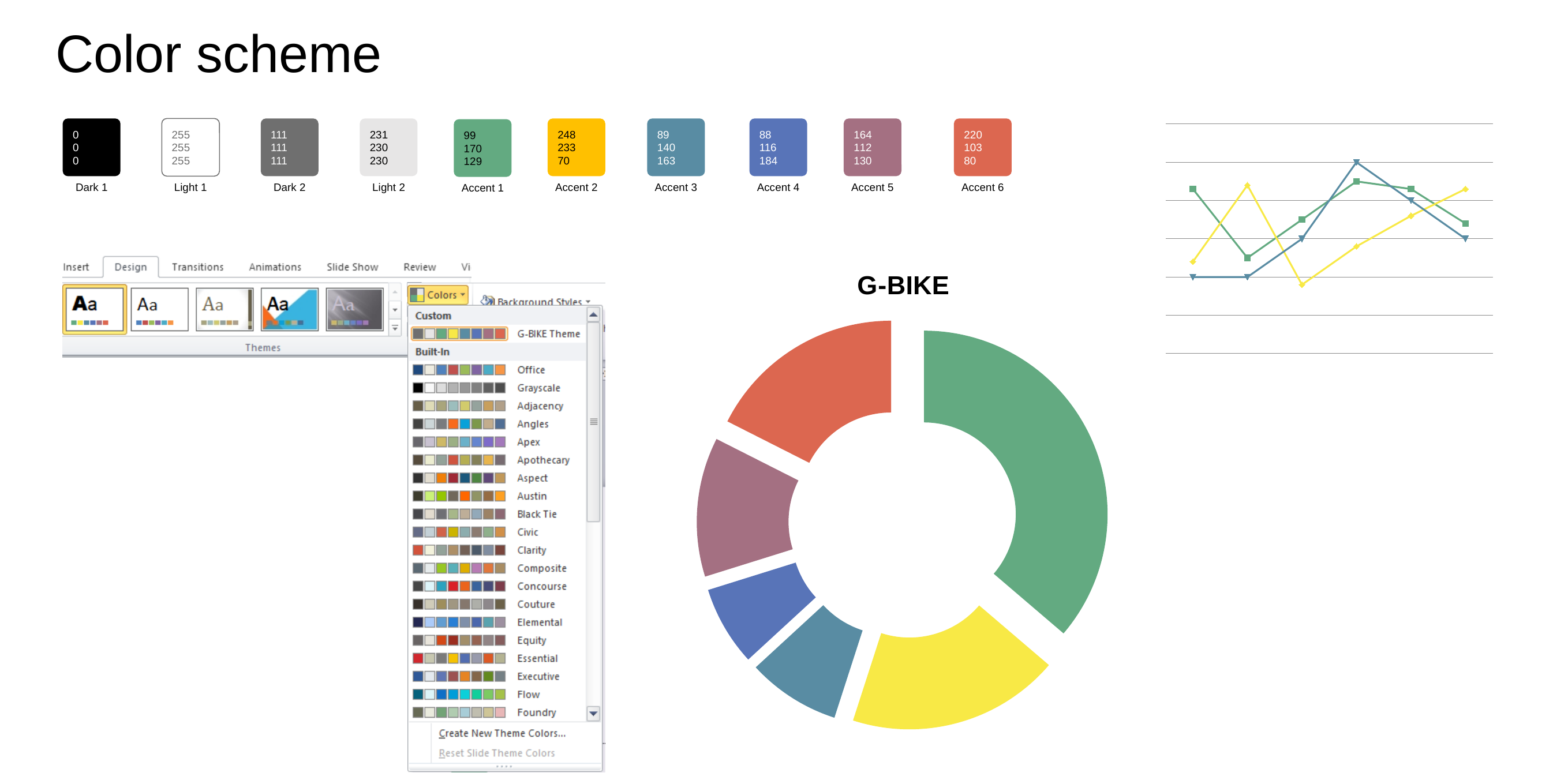
In the top-right line chart, which line has the highest value at the fourth point on the x axis? blue In the G-BIKE doughnut chart, which colour slice is the largest? green What is the title of the doughnut chart in the middle of the slide? G-BIKE What colours are the three lines in the top-right line chart? green, blue and yellow What kind of chart is the G-BIKE chart? doughnut chart In the top-right line chart, which line has the highest value at the first point on the x axis? green What kind of chart is shown at the top right of the slide? line chart How many lines are plotted in the line chart at the top right of the slide? 3 How many slices does the G-BIKE doughnut chart have? 6 In the G-BIKE doughnut chart, which is larger, the green slice or the yellow slice? green How many data points does each line in the top-right line chart have? 6